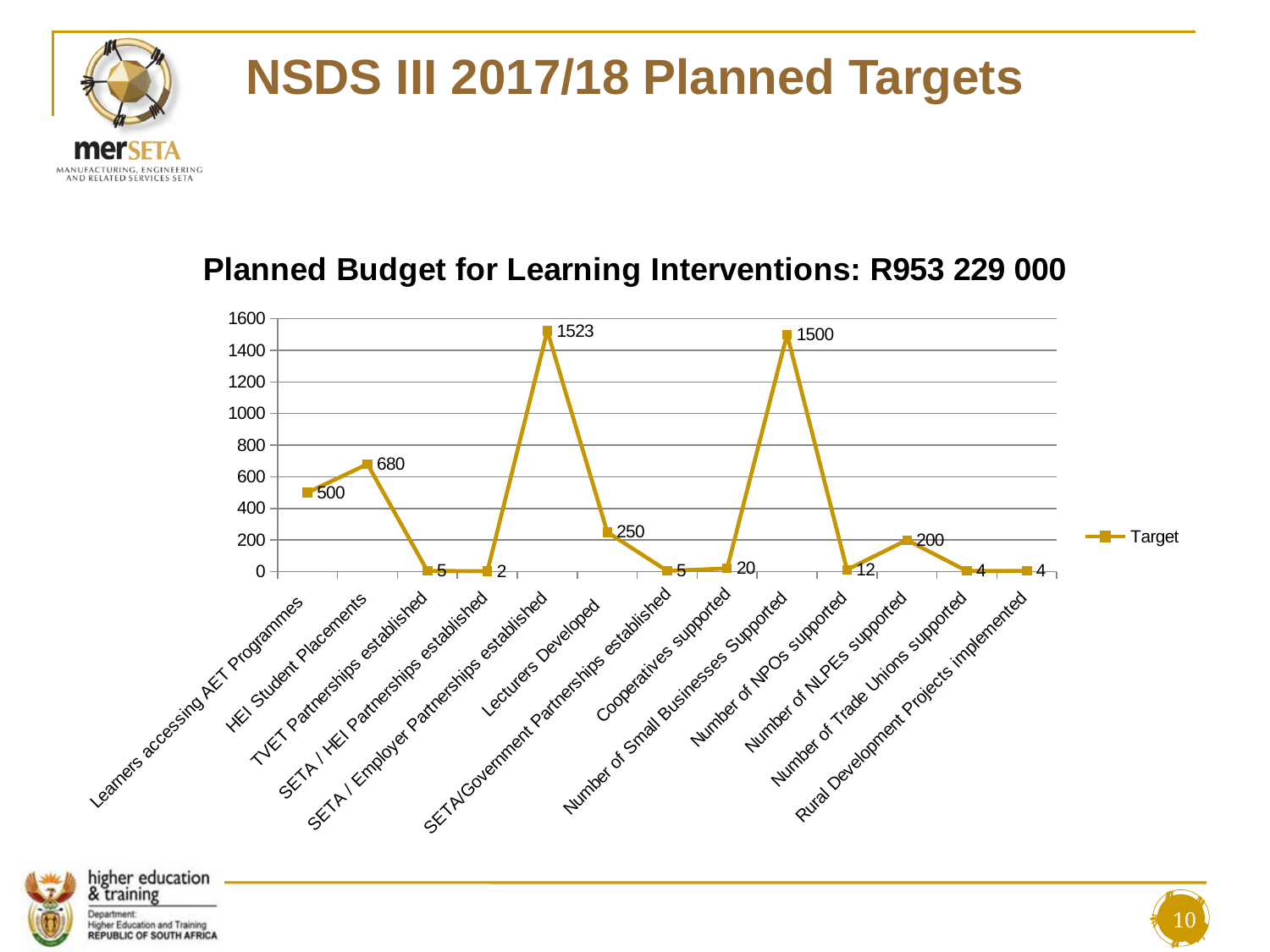
Which category has the lowest Target value? SETA / HEI Partnerships established What is the Target value for HEI Student Placements? 680 Which category has the highest Target value? SETA / Employer Partnerships established How many series does the legend list? 1 What is the difference between the Target for SETA / Employer Partnerships established and Number of Small Businesses Supported? 23 What is the Target value for Number of NLPEs supported? 200 Which is larger, the Target for Learners accessing AET Programmes or for HEI Student Placements? HEI Student Placements How many categories are plotted on the chart? 13 What is the Target value for Lecturers Developed? 250 What is the title of the chart? Planned Budget for Learning Interventions: R953 229 000 What kind of chart is shown on the slide? Line chart What is the Target value for Cooperatives supported? 20